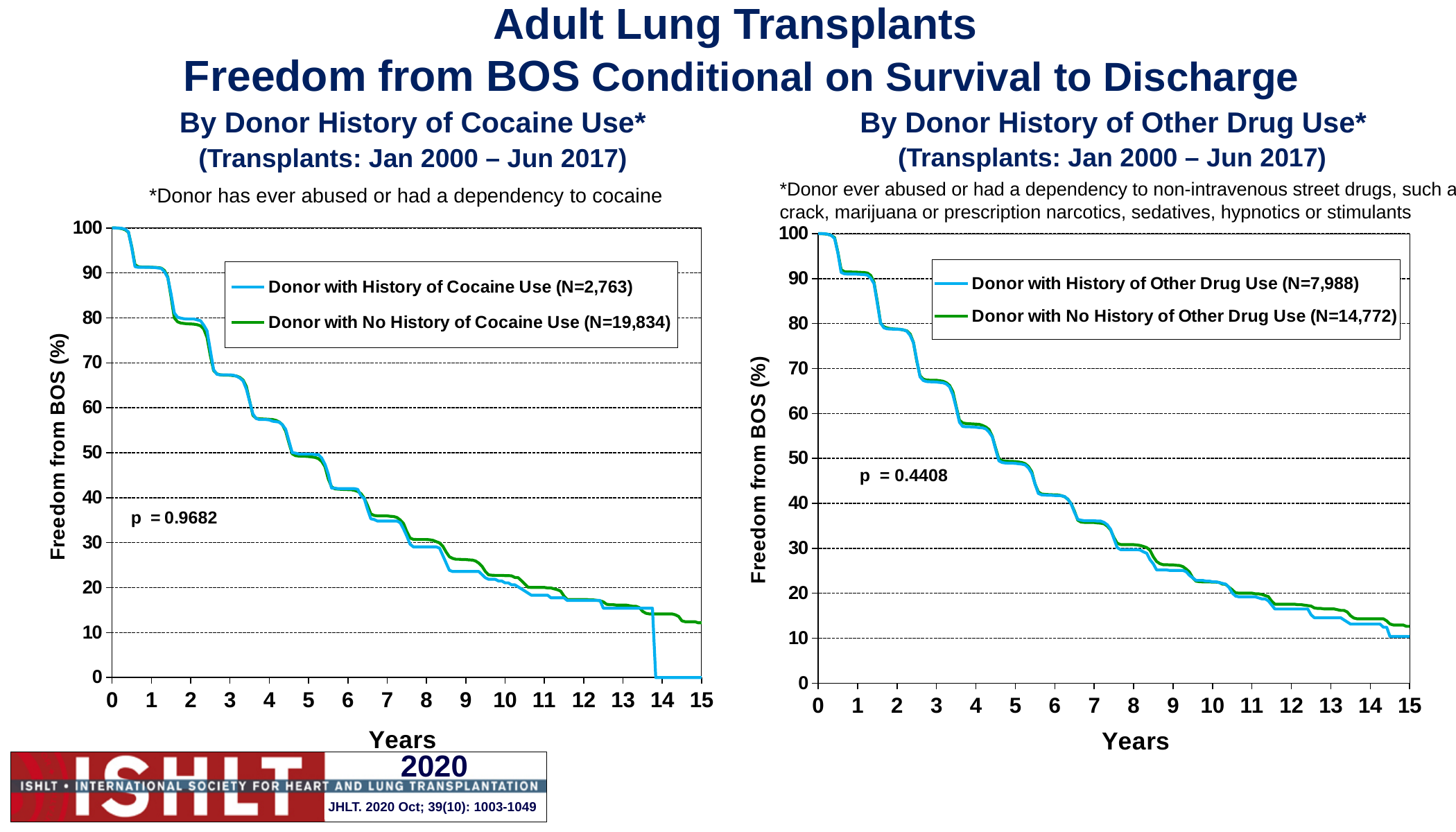
In the right chart, 'By Donor History of Other Drug Use', is the value for donors with a history of other drug use at year 12 greater or less than 20? less In the right chart, 'By Donor History of Other Drug Use', is the value for donors with no history of other drug use at year 4 greater or less than 50? greater In the left chart, 'By Donor History of Cocaine Use', is the value for donors with a history of cocaine use at year 8 greater or less than 30? less In the left chart, 'By Donor History of Cocaine Use', do the curves rise or fall as years increase? fall In the right chart, 'By Donor History of Other Drug Use', what is the N for donors with a history of other drug use according to the legend? N=7,988 In the left chart, 'By Donor History of Cocaine Use', what is the freedom from BOS for donors with a history of cocaine use at year 15? 0 What p-value is shown on the left chart, 'By Donor History of Cocaine Use'? p = 0.9682 How many series does the legend of the right chart, 'By Donor History of Other Drug Use', list? 2 In the right chart, 'By Donor History of Other Drug Use', which series is higher at year 15? Donor with No History of Other Drug Use In the left chart, 'By Donor History of Cocaine Use', what is the freedom from BOS for both series at year 0? 100 What kind of chart is the left chart, 'By Donor History of Cocaine Use'? line chart